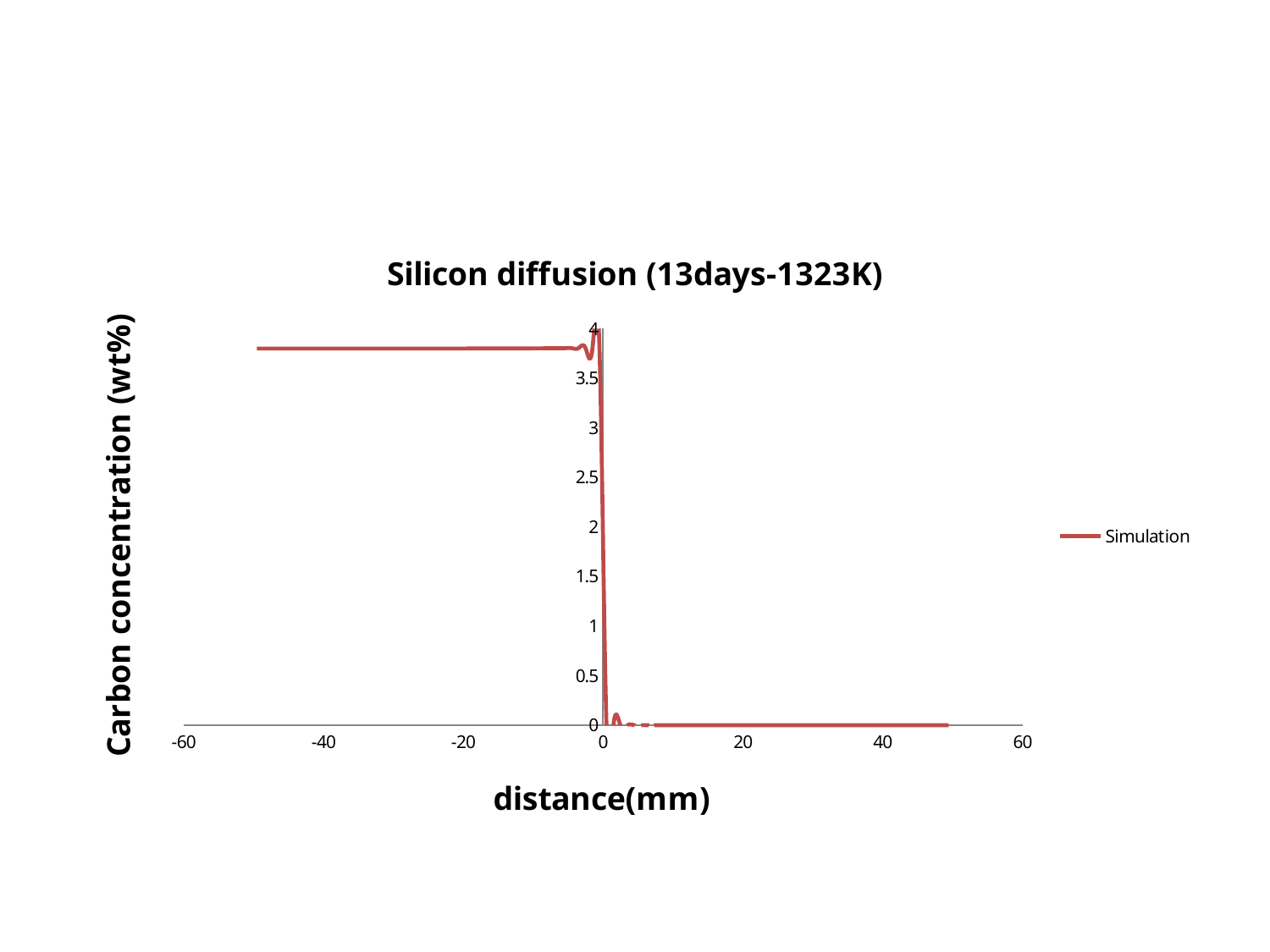
Is the Simulation value at a distance of -20 mm greater or less than 3? greater What is the name of the series shown in the legend? Simulation What is the label of the y axis? Carbon concentration (wt%) What is the title of the chart? Silicon diffusion (13days-1323K) How many series does the legend list? 1 What kind of chart is shown on the slide? line chart Moving from left to right along the x axis, does the Simulation curve overall rise or fall? fall Is the Simulation value at a distance of -40 mm greater or less than 3.5? greater Is the Simulation value at a distance of 20 mm greater or less than 0.5? less Which is larger, the Simulation value at -20 mm or at 20 mm? -20 mm